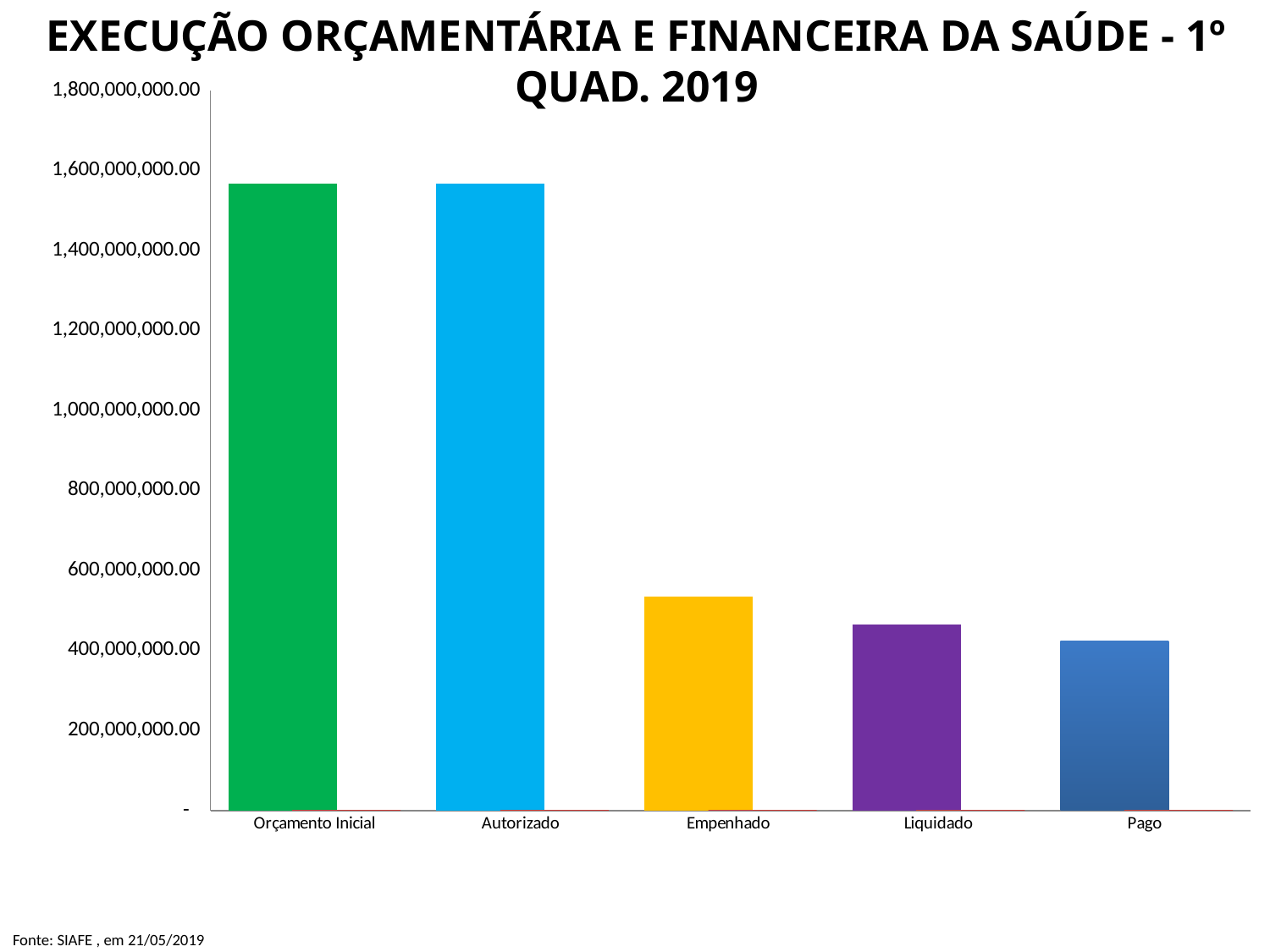
What is the title of the chart? EXECUÇÃO ORÇAMENTÁRIA E FINANCEIRA DA SAÚDE - 1º QUAD. 2019 Do the values generally rise or fall moving from left to right along the x axis? Fall Is the value for Liquidado greater or less than 600,000,000.00? less Is the value for Autorizado greater or less than 1,800,000,000.00? less Is the value for Empenhado greater or less than 400,000,000.00? greater Which category has the lowest value in the chart? Pago Which is larger, the value for Empenhado or the value for Liquidado? Empenhado How many categories are shown on the x axis of the chart? 5 What kind of chart is shown on the slide? Bar chart